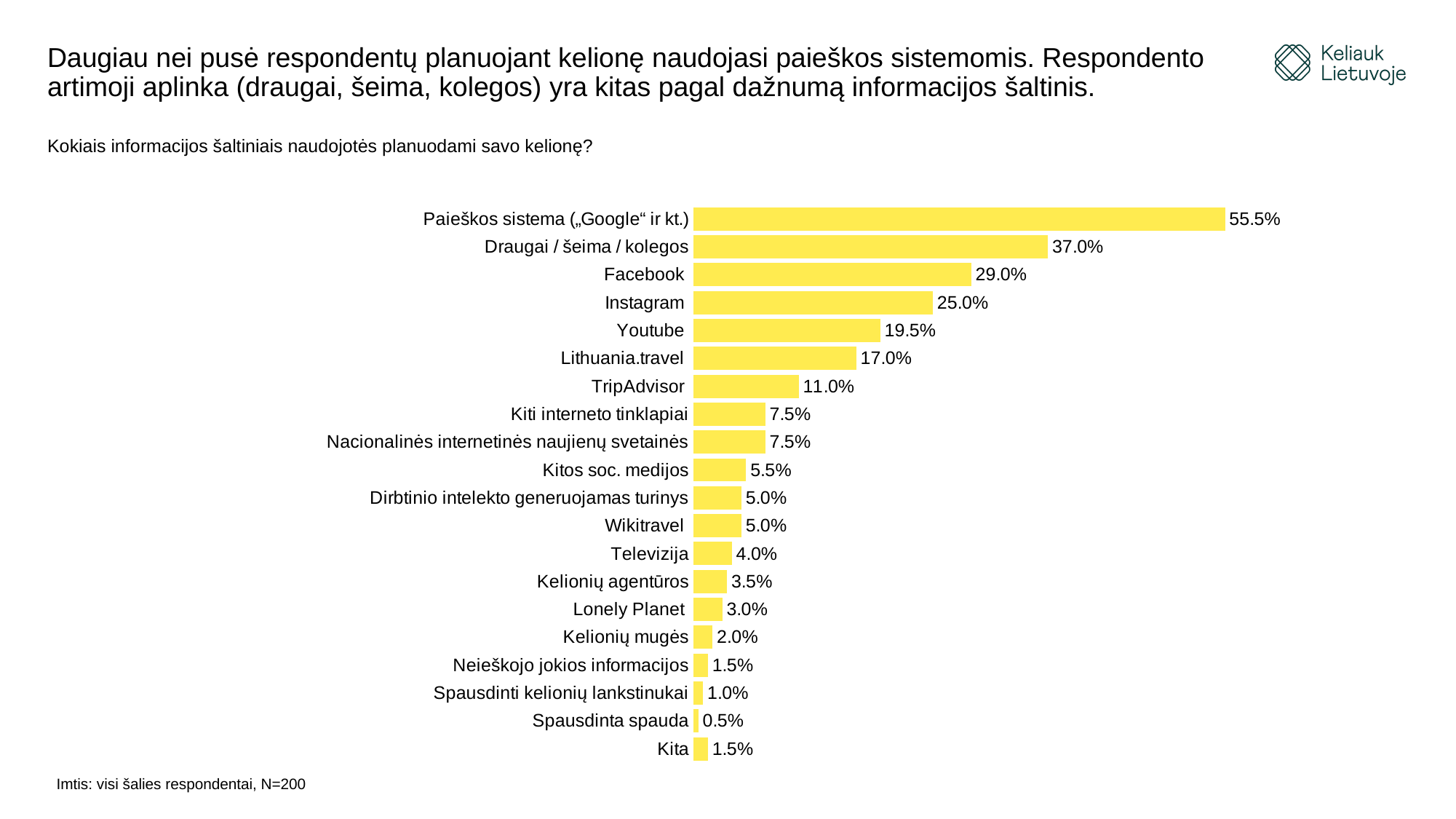
What is the value for Facebook? 29.0% What is the value for Lithuania.travel? 17.0% What is the value for TripAdvisor? 11.0% What is the value for Kelionių mugės? 2.0% What is the difference between the values for Paieškos sistema („Google“ ir kt.) and Draugai / šeima / kolegos? 18.5% Which category has the highest value? Paieškos sistema („Google“ ir kt.) Which is larger, the value for Televizija or the value for Lonely Planet? Televizija What kind of chart is shown on the slide? Bar chart Which category has the lowest value? Spausdinta spauda What colour are the bars in the chart? Yellow How many categories are shown in the chart? 20 What is the difference between the values for Instagram and Youtube? 5.5%